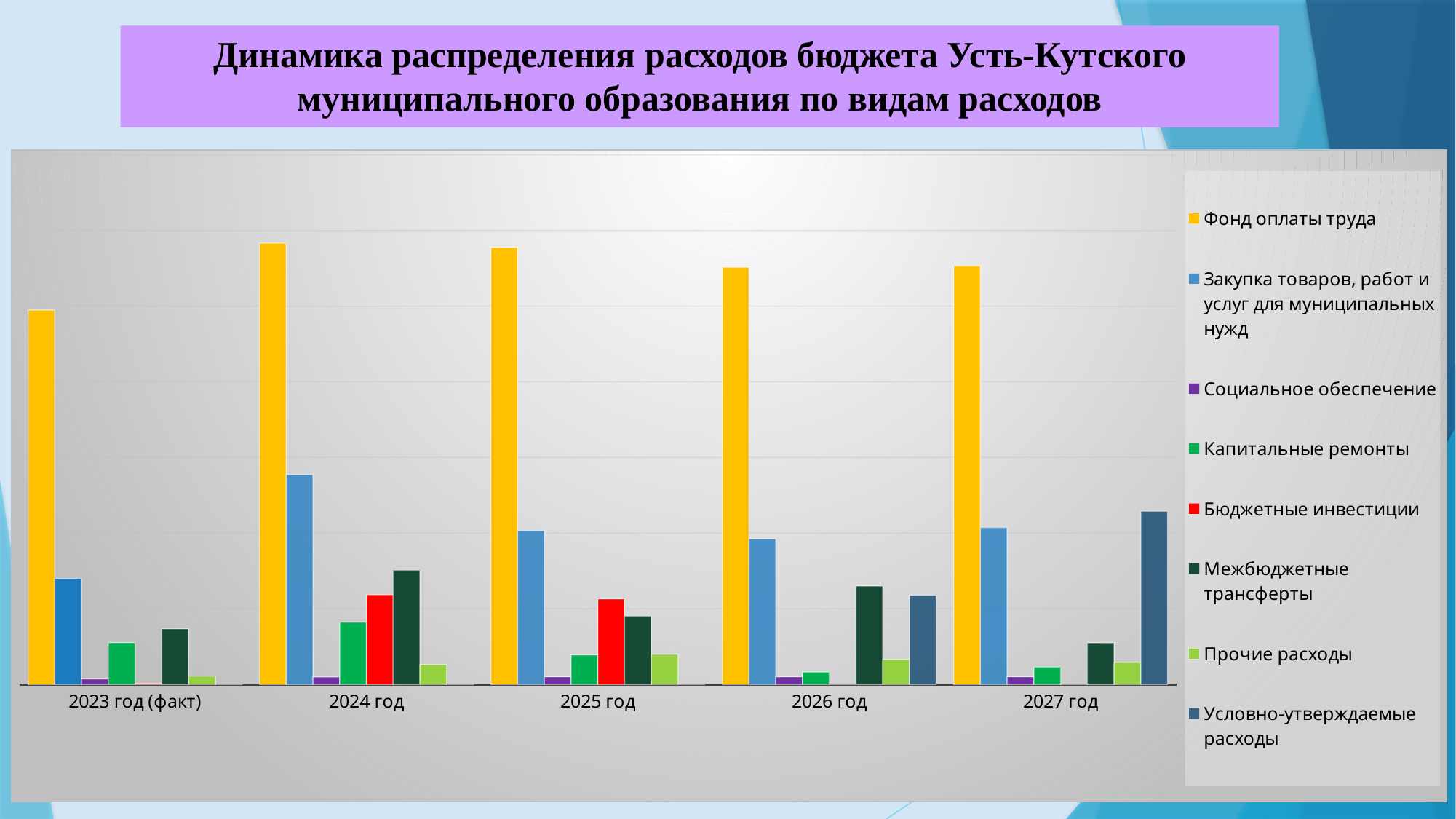
What kind of chart is shown on the slide? bar chart In which year is the value for Условно-утверждаемые расходы the highest? 2027 год In which year is the value for Межбюджетные трансферты the highest? 2024 год Is the value for Условно-утверждаемые расходы larger in 2026 год or in 2027 год? 2027 год Which series has the highest value in 2024 год? Фонд оплаты труда In which year is the value for Фонд оплаты труда the lowest? 2023 год (факт) What is the title of the slide? Динамика распределения расходов бюджета Усть-Кутского муниципального образования по видам расходов Is the value for Капитальные ремонты larger in 2024 год or in 2027 год? 2024 год How many series does the legend list? 8 Is the value for Закупка товаров, работ и услуг для муниципальных нужд larger in 2023 год (факт) or in 2024 год? 2024 год How many year categories are shown on the x axis? 5 Which series is shown in red in the legend? Бюджетные инвестиции